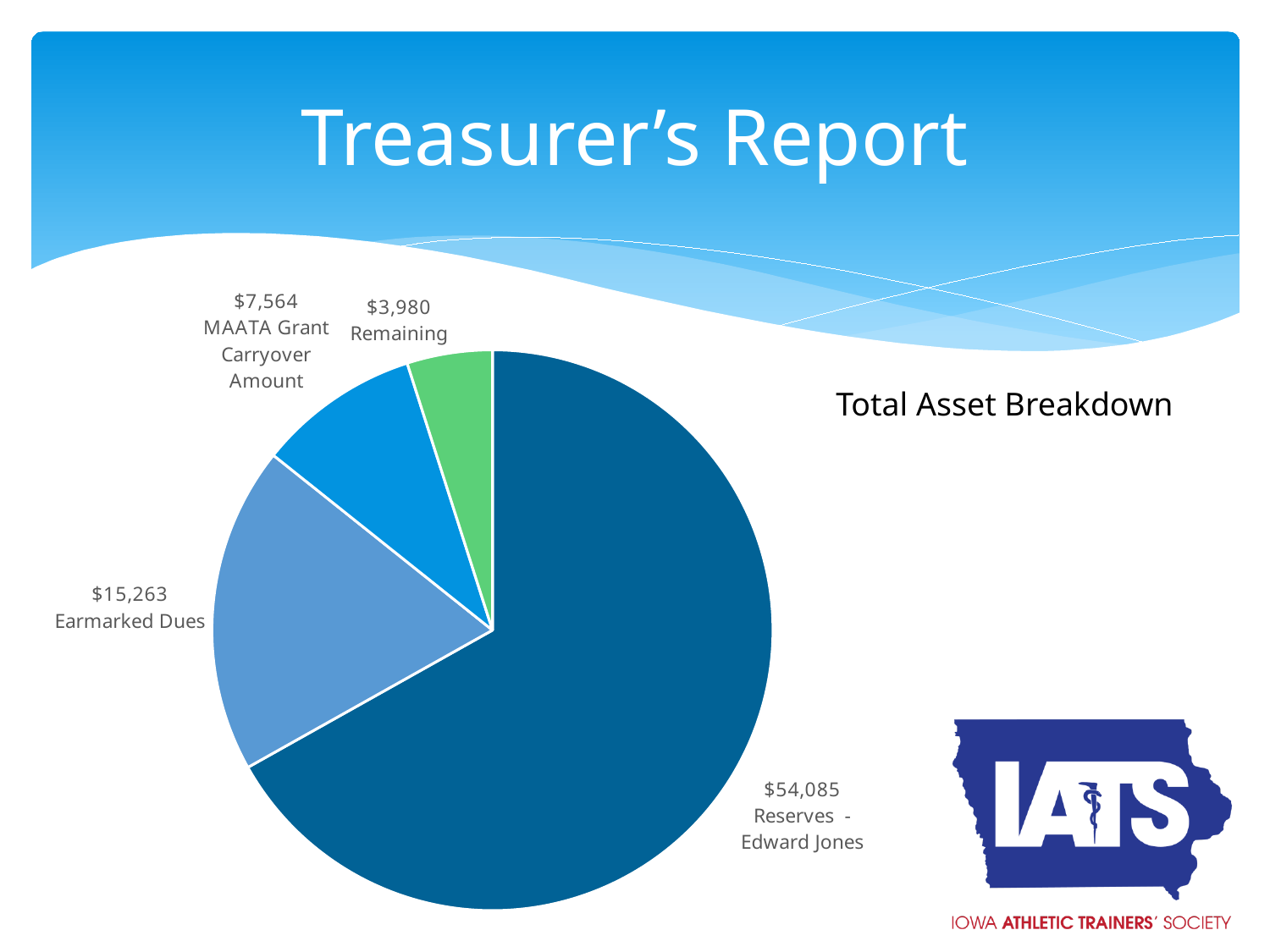
What is the value of the Reserves - Edward Jones slice? $54,085 Which category has the largest slice in the pie chart? Reserves - Edward Jones Which is larger, the MAATA Grant Carryover Amount or the Remaining amount? MAATA Grant Carryover Amount What is the difference between the Reserves - Edward Jones value and the Earmarked Dues value? $38,822 What is the title of the chart on the slide? Total Asset Breakdown What is the value of the MAATA Grant Carryover Amount slice? $7,564 What is the value of the Remaining slice? $3,980 What is the total of all four slices in the Total Asset Breakdown pie chart? $80,892 Which category has the smallest slice in the pie chart? Remaining What kind of chart is shown on the slide? Pie chart What is the value of the Earmarked Dues slice? $15,263 How many slices does the Total Asset Breakdown pie chart have? 4